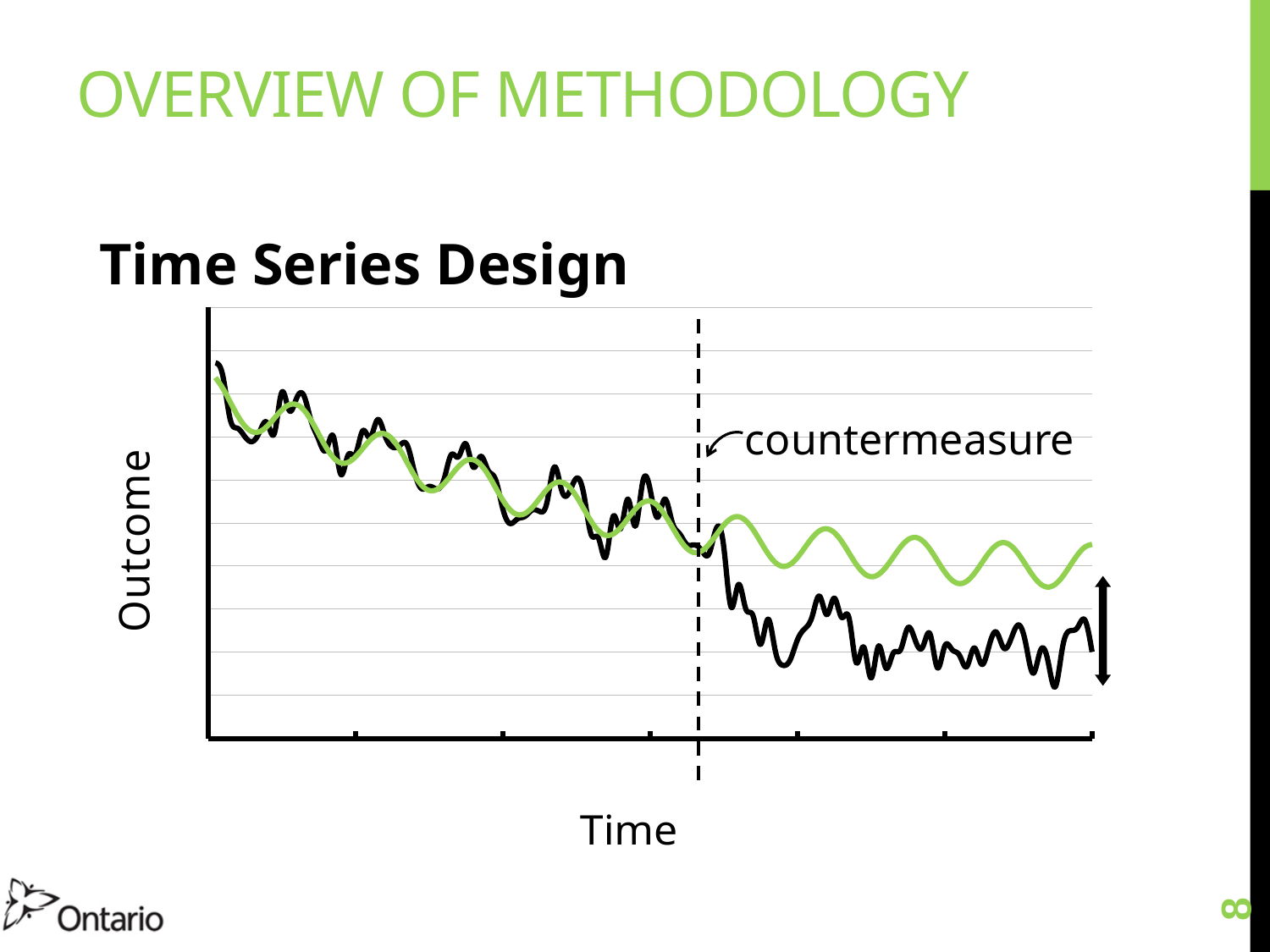
How many lines are plotted on the chart? 2 What is the label on the horizontal axis of the chart? Time What is the label on the vertical axis of the chart? Outcome Which line, green or black, shows the lower outcome at the right end of the chart? the black line What kind of chart is shown under the heading "Time Series Design"? line chart Does the black line rise or fall immediately after the dashed countermeasure line? fall Do the plotted lines generally rise or fall as time increases along the x axis? fall After the countermeasure line, which plotted line is higher, the green line or the black line? the green line